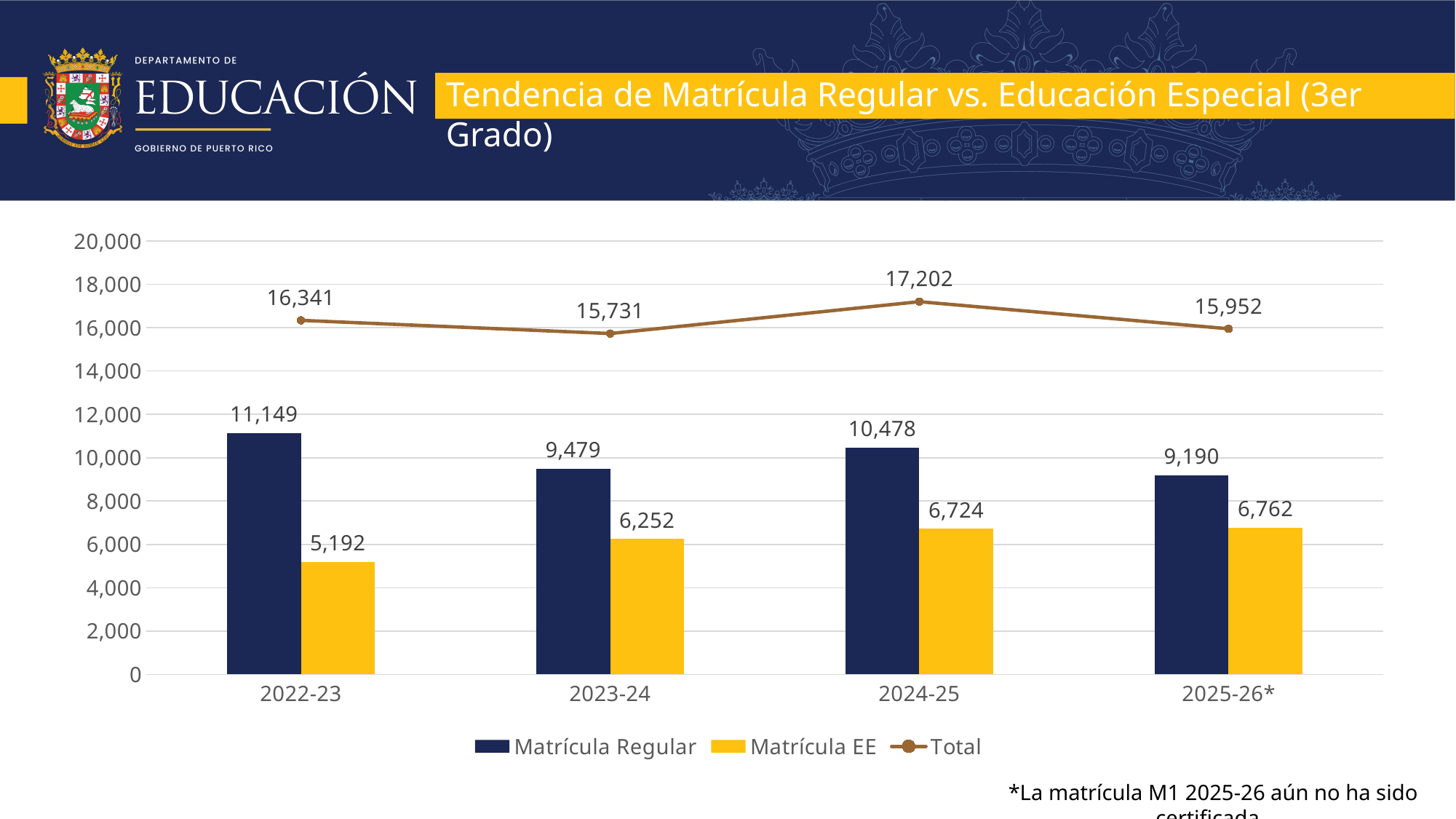
What colour are the Matrícula EE bars? Yellow What is the difference between Matrícula Regular and Matrícula EE in 2025-26*? 2,428 What is the Matrícula EE value for 2024-25? 6,724 What kind of chart is this? Combined bar and line chart Does the Matrícula Regular value rise or fall from 2022-23 to 2023-24? Fall Which year has the lowest Matrícula EE value? 2022-23 What is the Total value for 2023-24? 15,731 Which is larger, the Matrícula Regular value for 2023-24 or for 2024-25? 2024-25 Which year has the highest Total value? 2024-25 How many years are shown on the x axis? 4 How many series does the legend list? 3 What is the Matrícula Regular value for 2022-23? 11,149